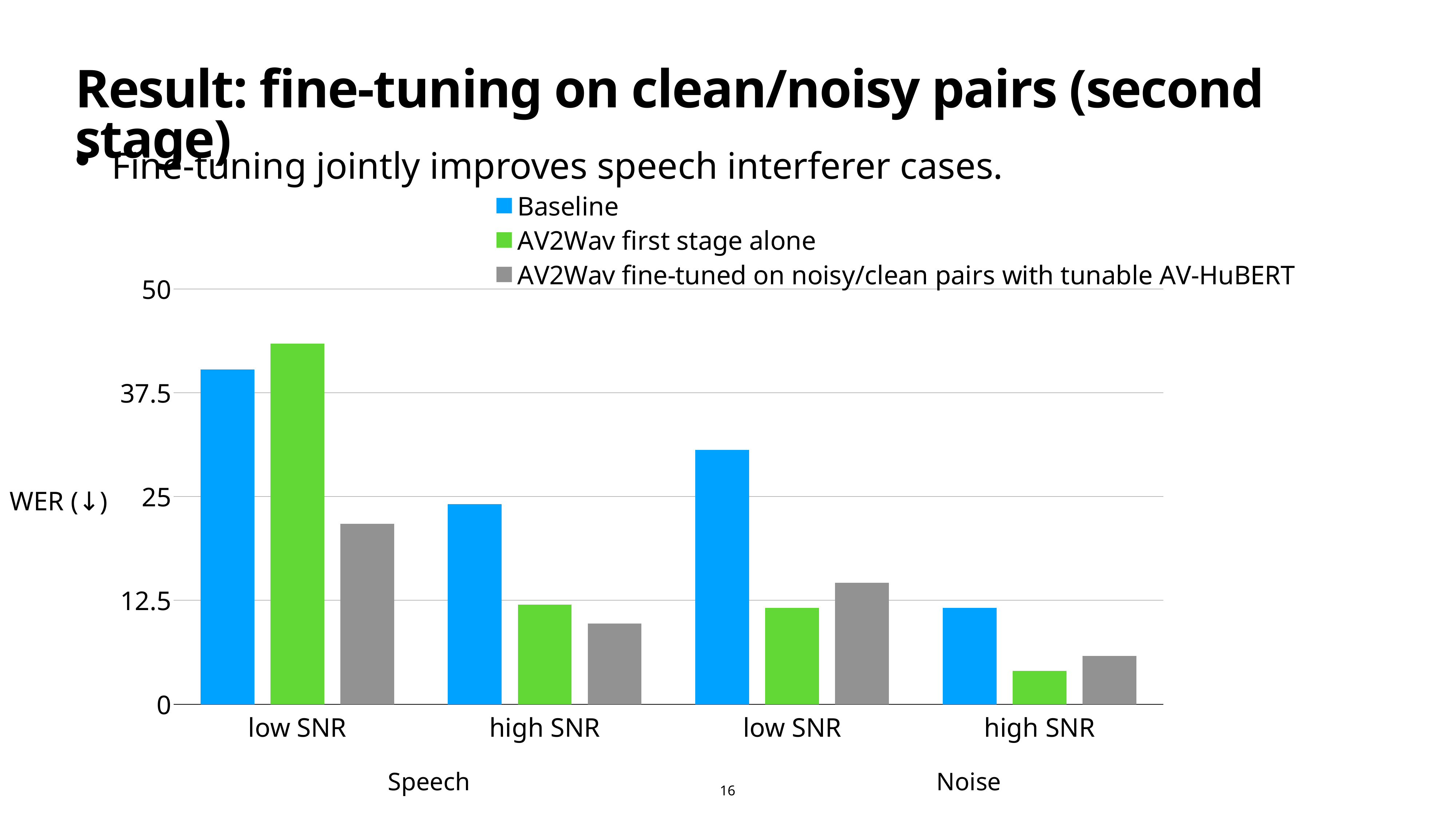
Which series has the lowest value for high SNR under Noise? AV2Wav first stage alone What is the label on the y axis? WER (↓) For high SNR under Speech, which is larger: the AV2Wav first stage alone value or the AV2Wav fine-tuned value? AV2Wav first stage alone Is the Baseline value for low SNR under Noise greater or less than 25? greater What kind of chart is shown on the slide? bar chart How many category groups are shown along the x axis? 4 How many series does the legend list? 3 For low SNR under Noise, which is larger: the Baseline value or the AV2Wav first stage alone value? Baseline Is the AV2Wav first stage alone value for high SNR under Noise greater or less than 12.5? less Is the AV2Wav fine-tuned value for low SNR under Speech greater or less than 25? less Which series has the highest value for low SNR under Speech? AV2Wav first stage alone